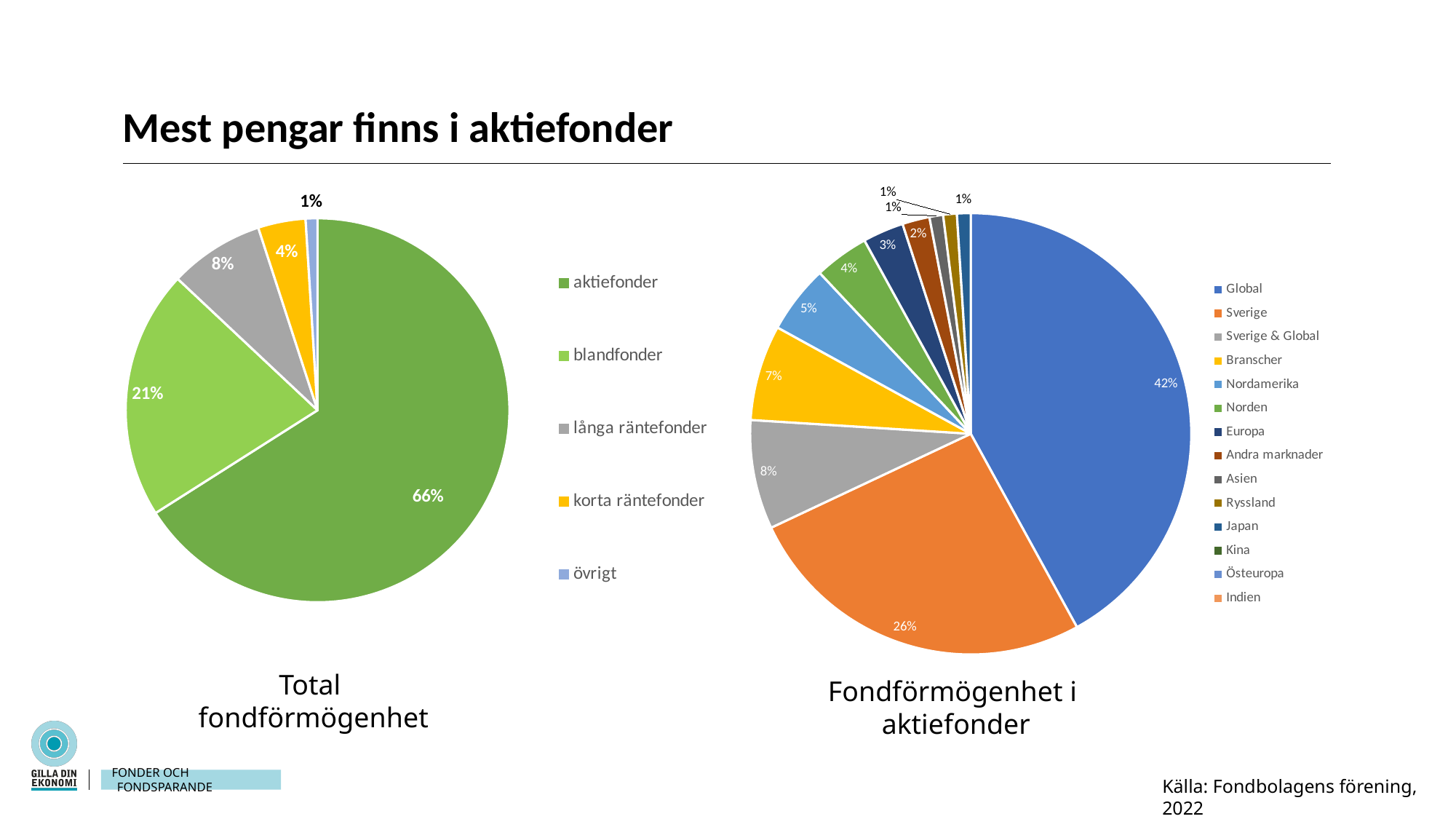
In the 'Fondförmögenhet i aktiefonder' pie chart, which category has the largest share? Global In the 'Total fondförmögenhet' pie chart, what share is aktiefonder? 66% In the 'Fondförmögenhet i aktiefonder' pie chart, what is the difference between the shares of Global and Sverige? 16% In the 'Fondförmögenhet i aktiefonder' pie chart, what share is Sverige? 26% In the 'Total fondförmögenhet' pie chart, how many categories does the legend list? 5 In the 'Total fondförmögenhet' pie chart, what is the difference between the shares of långa räntefonder and korta räntefonder? 4% What type of chart is used for 'Total fondförmögenhet'? Pie chart In the 'Total fondförmögenhet' pie chart, which category has the smallest share? övrigt In the 'Fondförmögenhet i aktiefonder' pie chart, what share is Global? 42% In the 'Fondförmögenhet i aktiefonder' pie chart, how many categories does the legend list? 14 In the 'Fondförmögenhet i aktiefonder' pie chart, which is larger, Branscher or Nordamerika? Branscher In the 'Total fondförmögenhet' pie chart, what share is blandfonder? 21%